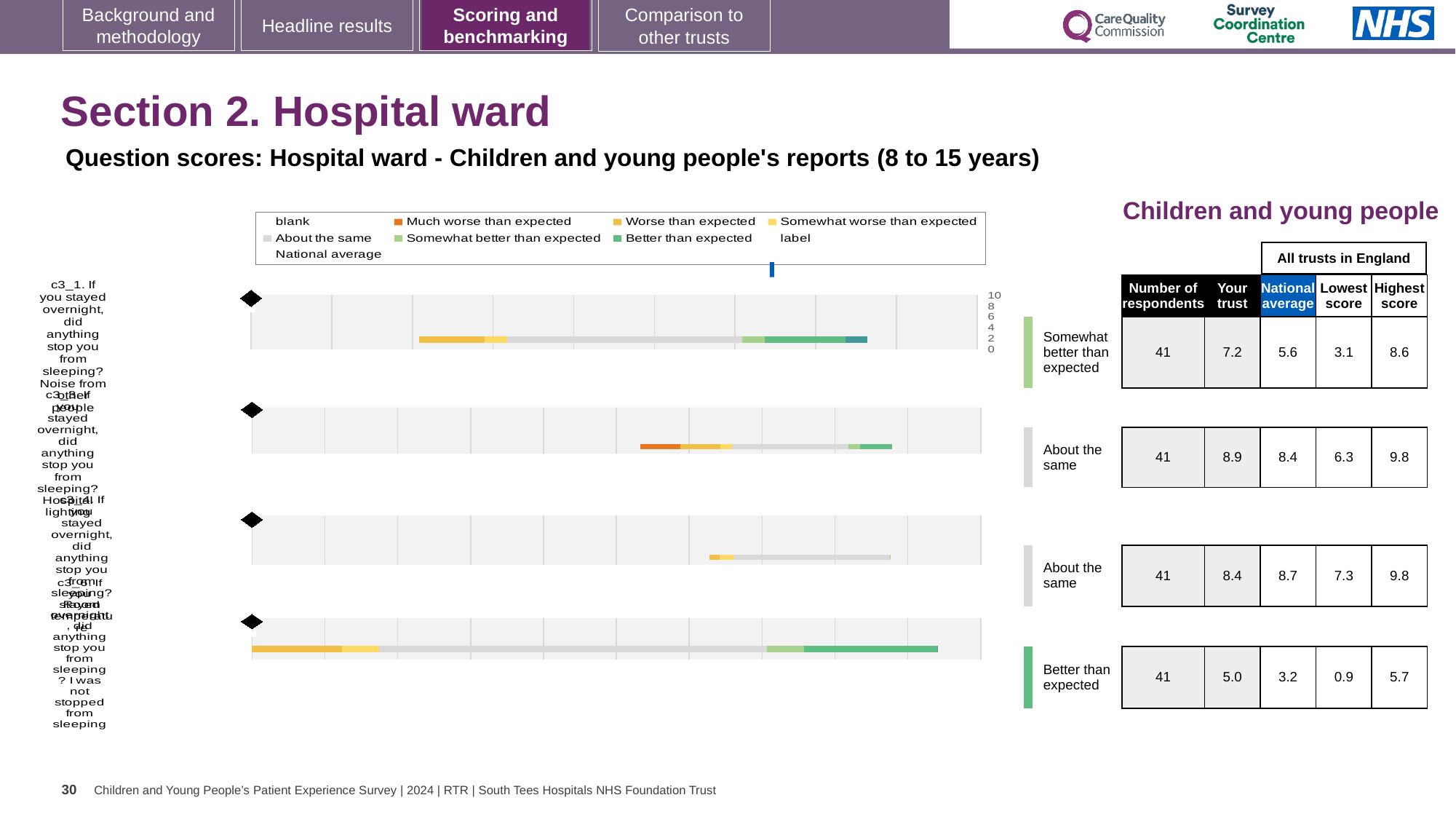
How many horizontal bars are plotted in the chart? 4 In the table beside the chart, what is the Highest score for the second row (About the same)? 9.8 How many entries does the chart legend list? 9 In the table beside the chart, what is the Lowest score for the last row (Better than expected)? 0.9 Which legend entry is shown in orange? Much worse than expected What kind of chart is shown on the slide? bar chart In the table beside the chart, what is the 'Your trust' score for the first row (Somewhat better than expected)? 7.2 In the table beside the chart, what is the difference between the 'Your trust' score and the National average for the first row (Somewhat better than expected)? 1.6 In the table beside the chart, how many respondents are listed for each row? 41 In the table beside the chart, which row has the highest 'Your trust' score? the second row (About the same), 8.9 In the table beside the chart, what is the National average for the last row (Better than expected)? 3.2 In the table beside the chart, which row has the lowest 'Your trust' score? the last row (Better than expected), 5.0